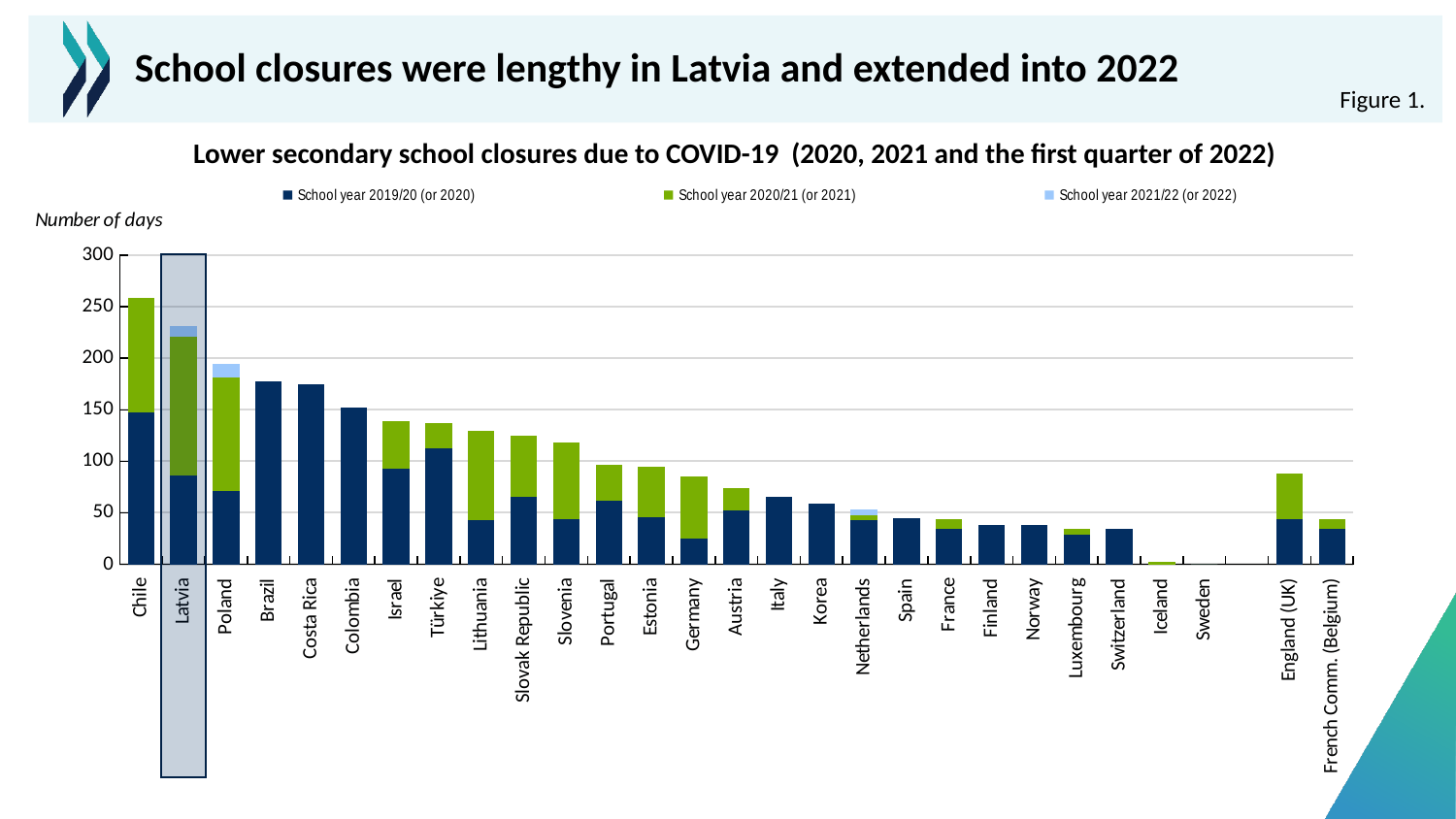
Which country is highlighted with a shaded box on the chart? Latvia How many series does the legend list? 3 What kind of chart is shown on the slide? Stacked bar chart Is the total value for Germany greater or less than 100? less Is the total value for Spain greater or less than 50? less Do the total bar heights generally rise or fall moving from Chile to Sweden along the x axis? fall Which country has the highest total number of school closure days? Chile Is the total value for Brazil greater or less than 150? greater Which has a larger total, Chile or Poland? Chile How many countries or regions are shown on the x axis? 28 Which country shows no visible bar at all (the lowest total)? Sweden